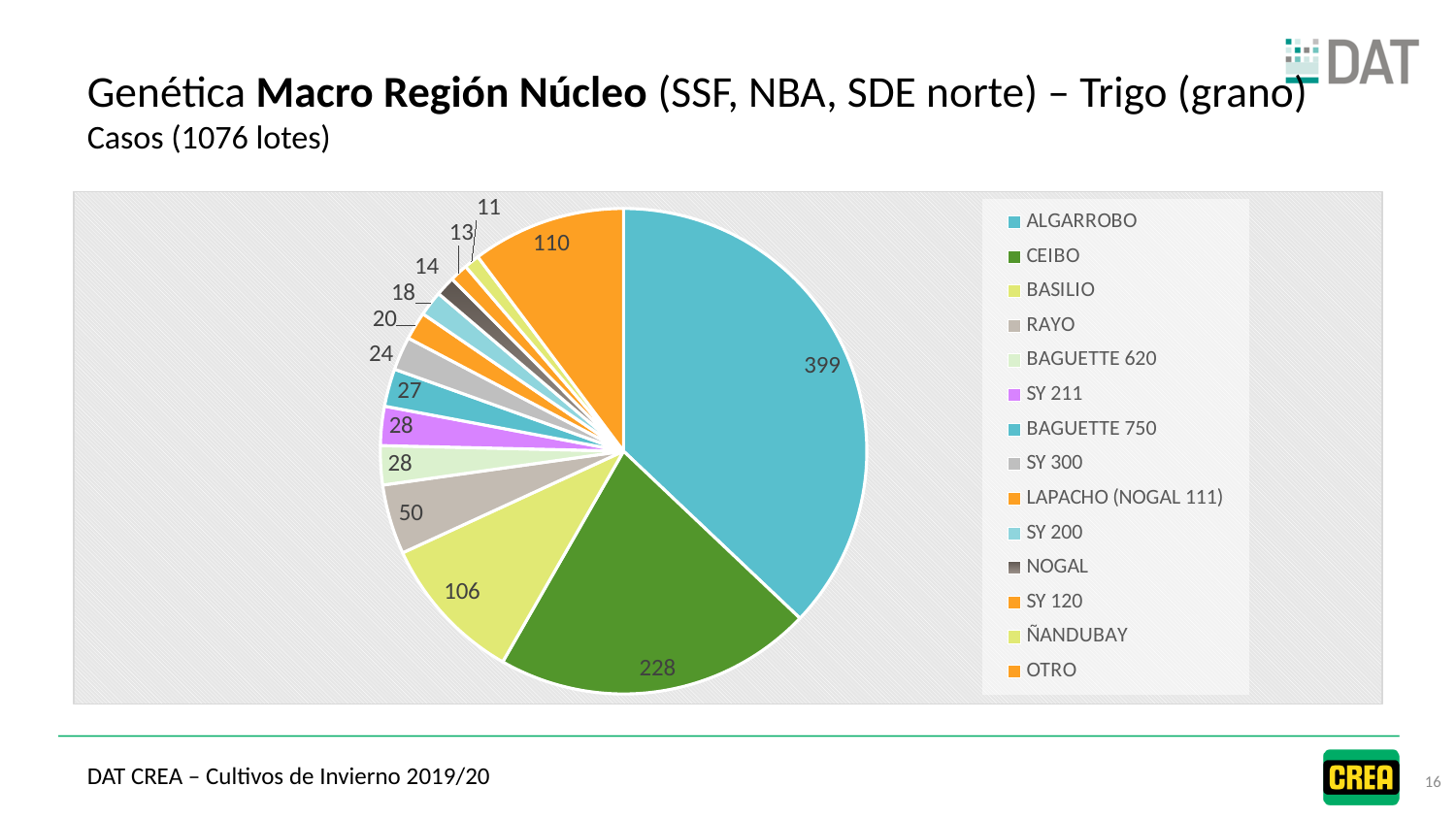
What kind of chart is shown on the slide? Pie chart What is the difference between the values for ALGARROBO and CEIBO? 171 What is the value for RAYO? 50 What is the value shown for CEIBO? 228 According to the subtitle, how many lots (lotes) are included in the chart? 1076 What value is labelled for the OTRO slice? 110 Which variety has the largest slice of the pie? ALGARROBO What share of the total 1076 lots does ALGARROBO represent? 37.1% Which has a larger value, BASILIO or OTRO? OTRO How many categories does the legend list? 14 How many lots does ALGARROBO account for in the pie chart? 399 Which variety has the smallest slice of the pie? ÑANDUBAY